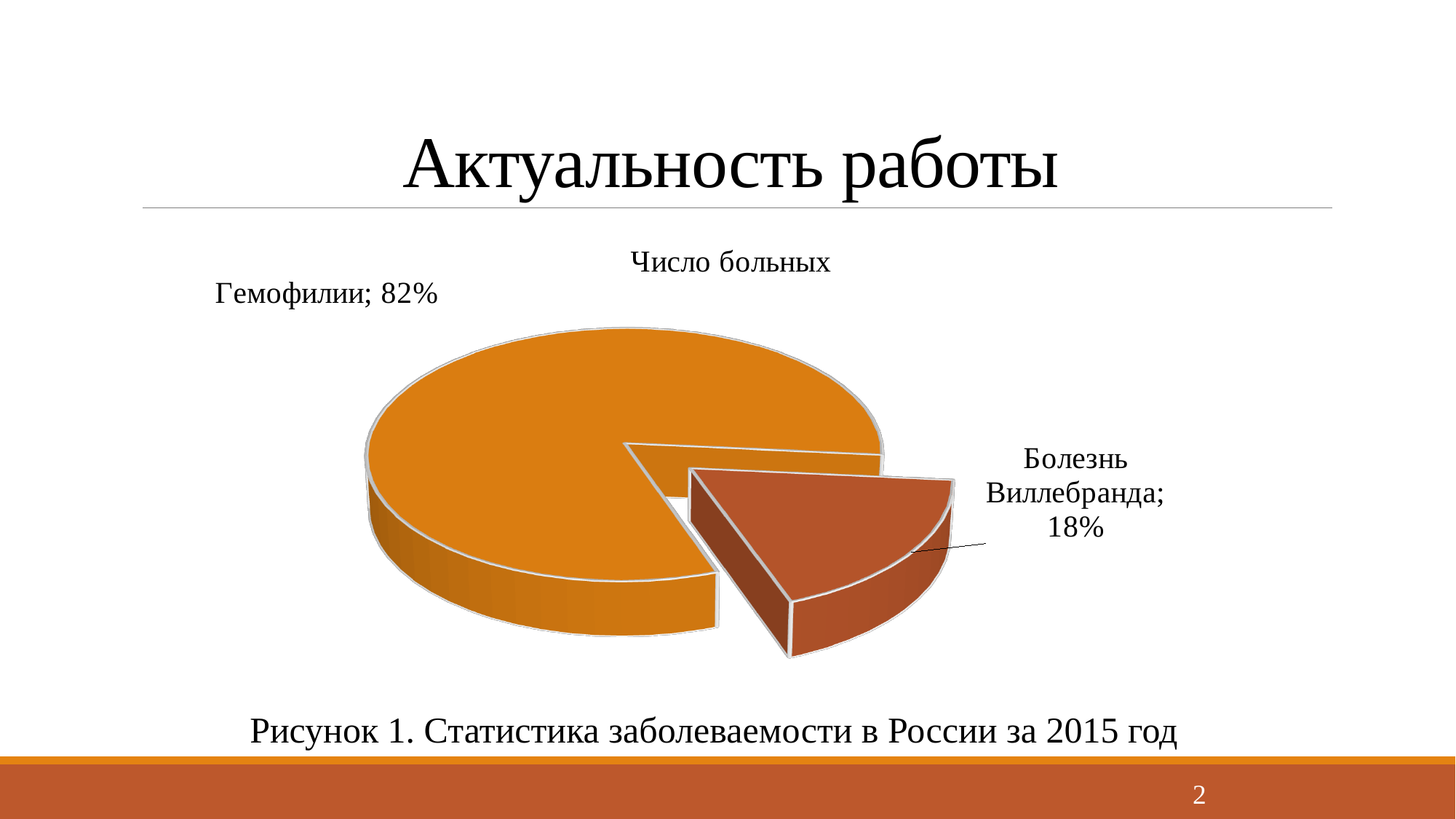
Which slice is the smallest? Болезнь Виллебранда What share of the pie does Гемофилии have? 82% Which slice is the largest? Гемофилии What colour is the Болезнь Виллебранда slice? Brown (reddish-brown) What is the difference in percentage points between the Гемофилии and Болезнь Виллебранда slices? 64 Which is larger, the share for Гемофилии or for Болезнь Виллебранда? Гемофилии What share of the pie does Болезнь Виллебранда have? 18% What is the title of the chart? Число больных What kind of chart is shown on the slide? Pie chart How many slices does the pie chart have? 2 What is the caption below the chart? Рисунок 1. Статистика заболеваемости в России за 2015 год